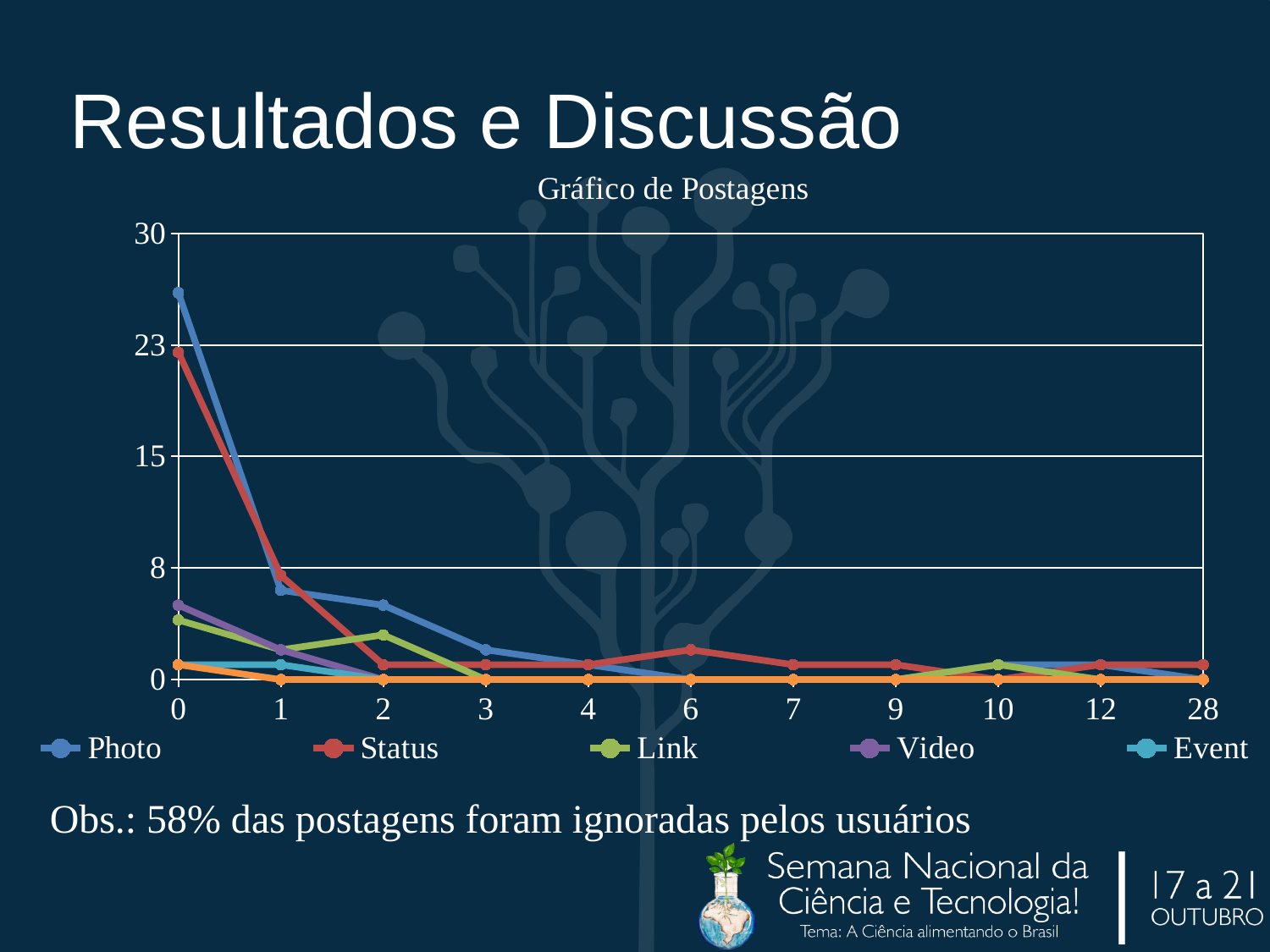
What is the title of the chart? Gráfico de Postagens Is the value for Photo at x = 0 greater or less than 23? greater Is the value for Link at x = 0 greater or less than 8? less Which series has the highest value at x = 0? Photo Which series is listed last in the legend? Event Does the Photo series generally rise or fall along the x axis? fall Is the value for Photo at x = 1 greater or less than 8? less At x = 2, which is larger, Photo or Status? Photo What kind of chart is shown on the slide? line chart How many series does the legend list? 5 At x = 0, which is larger, Photo or Status? Photo How many points are labelled along the x axis? 11